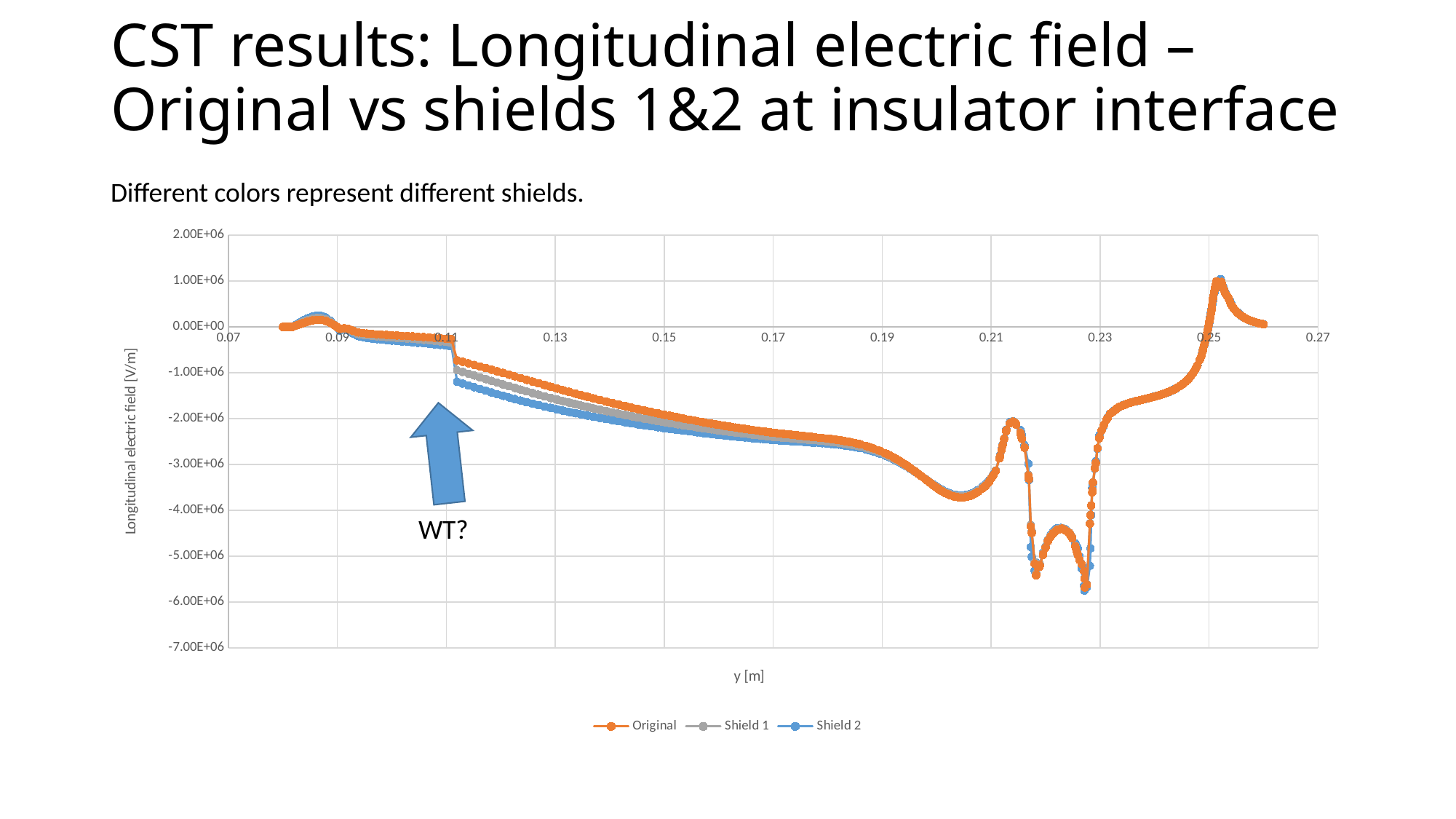
Between y = 0.11 m and y = 0.20 m, do the plotted values rise or fall along the x axis? fall Is the lowest value reached by the Original series greater or less than -5.00E+06? less How many series does the legend list? 3 What kind of chart is shown on the slide? line chart What is the label of the vertical axis? Longitudinal electric field [V/m] What are the names of the series listed in the legend? Original, Shield 1, Shield 2 Just after the step at about y = 0.11 m, which series has the lowest (most negative) value? Shield 2 Just after the step at about y = 0.11 m, which series has the highest value? Original Between y = 0.23 m and y = 0.25 m, do the plotted values rise or fall along the x axis? rise At y = 0.13 m, which series has the larger value, Original or Shield 2? Original Is the value of the Shield 2 series at y = 0.13 m greater or less than -1.00E+06? less Is the value of the Original series at y = 0.19 m greater or less than -3.00E+06? greater